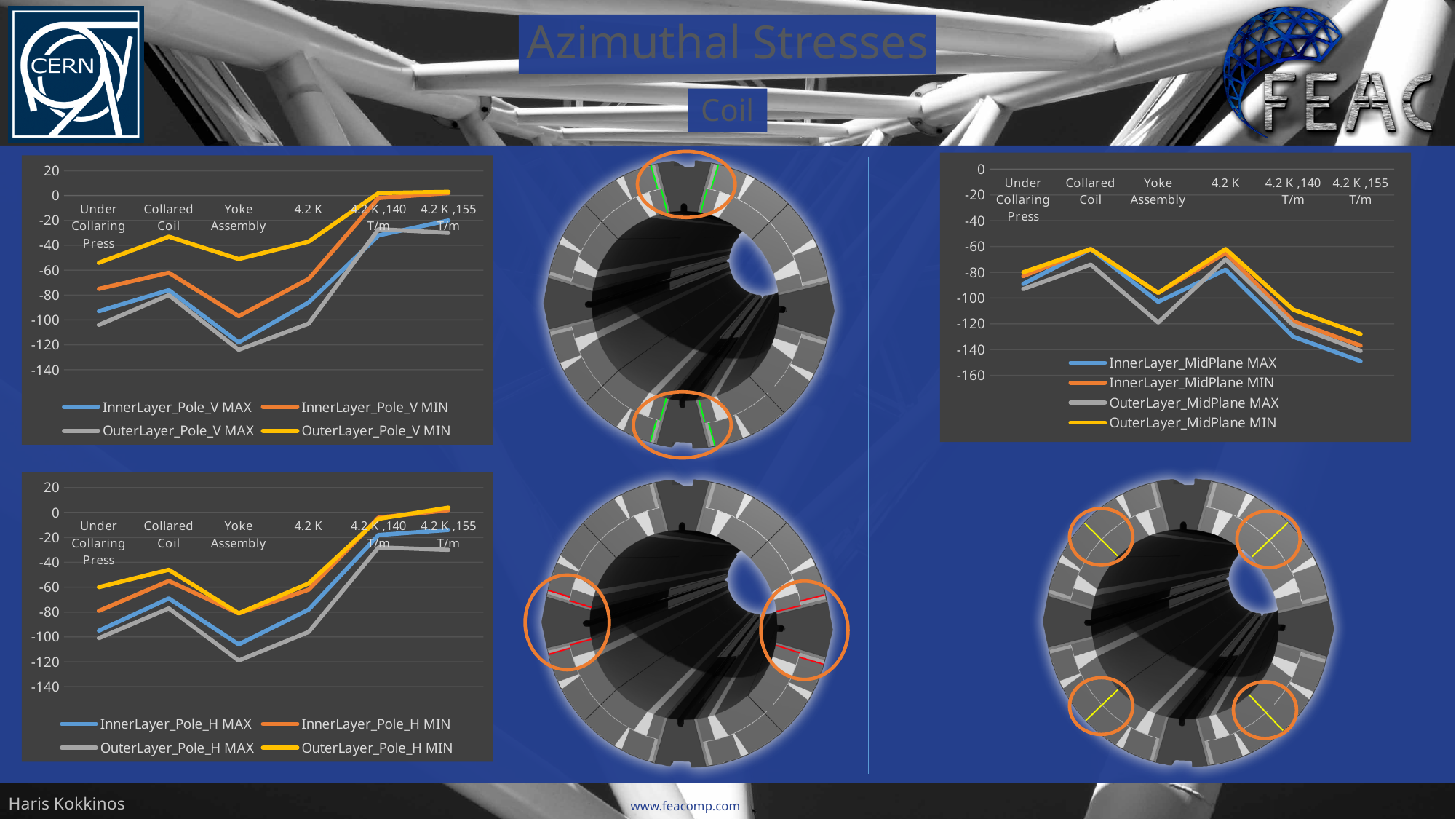
How many series does the legend of the right-hand chart (MidPlane) list? 4 What kind of chart is the top-left chart (Pole_V)? line chart In the bottom-left chart (Pole_H), is the value of InnerLayer_Pole_H MAX at Under Collaring Press greater or less than -80? less In the top-left chart (Pole_V), is the value of OuterLayer_Pole_V MAX at Yoke Assembly greater or less than -100? less In the top-left chart (Pole_V), which series has the highest value at Yoke Assembly? OuterLayer_Pole_V MIN In the bottom-left chart (Pole_H), do the values rise or fall from 4.2 K to 4.2 K ,140 T/m? rise In the right-hand chart (MidPlane), do the values rise or fall from 4.2 K to 4.2 K ,155 T/m? fall In the bottom-left chart (Pole_H), which series has the lowest value at Yoke Assembly? OuterLayer_Pole_H MAX How many categories are shown on the x axis of the bottom-left chart (Pole_H)? 6 In the right-hand chart (MidPlane), which series has the lowest value at 4.2 K ,155 T/m? InnerLayer_MidPlane MAX In the top-left chart (Pole_V), which series has the lowest value at Yoke Assembly? OuterLayer_Pole_V MAX In the right-hand chart (MidPlane), is the value of OuterLayer_MidPlane MAX at Yoke Assembly greater or less than -100? less